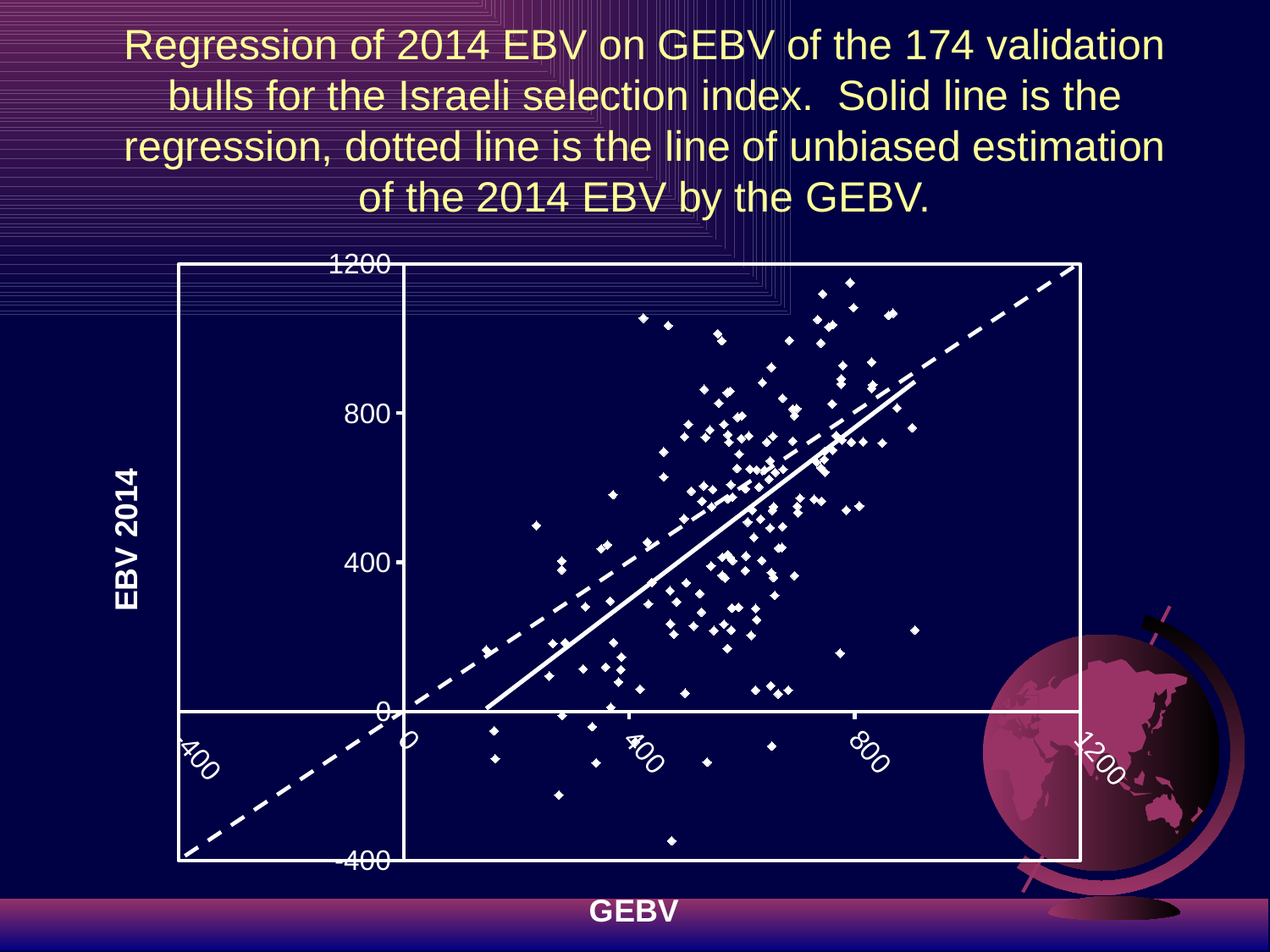
What does the solid line in the chart represent? the regression What kind of chart is shown on the slide? scatter plot Is the EBV 2014 value of the lowest plotted point greater or less than 0? less Is the EBV 2014 value of the highest plotted point greater or less than 800? greater What is the label of the x axis? GEBV Do the EBV 2014 values generally rise or fall as GEBV increases along the x axis? rise How many validation bulls are plotted in the chart? 174